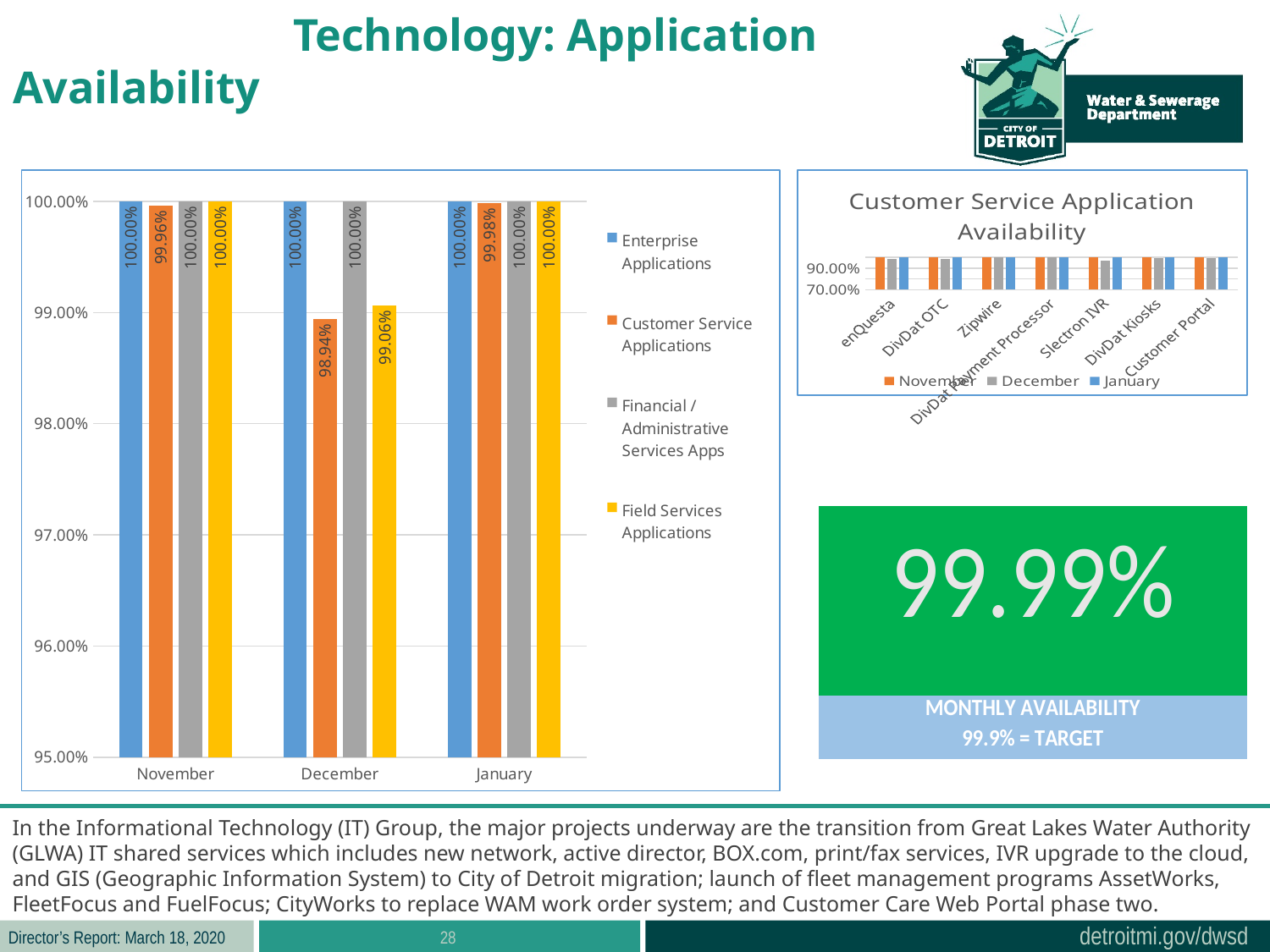
In the left chart, what is the value for Customer Service Applications in December? 98.94% What kind of chart is the left chart? bar chart In the left chart, what is the difference between the Field Services Applications and Customer Service Applications values in December? 0.12% In the left chart, what is the value for Customer Service Applications in January? 99.98% How many series does the legend of the Customer Service Application Availability chart list? 3 In the left chart, is the value for Customer Service Applications in December greater or less than 99.00%? less In the left chart, what is the value for Customer Service Applications in November? 99.96% How many categories are shown on the x axis of the Customer Service Application Availability chart? 7 In the left chart, which series has the lowest value in December? Customer Service Applications In the left chart, which is larger: Customer Service Applications in November or Customer Service Applications in December? November How many series does the legend of the left chart list? 4 In the left chart, what is the value for Field Services Applications in December? 99.06%